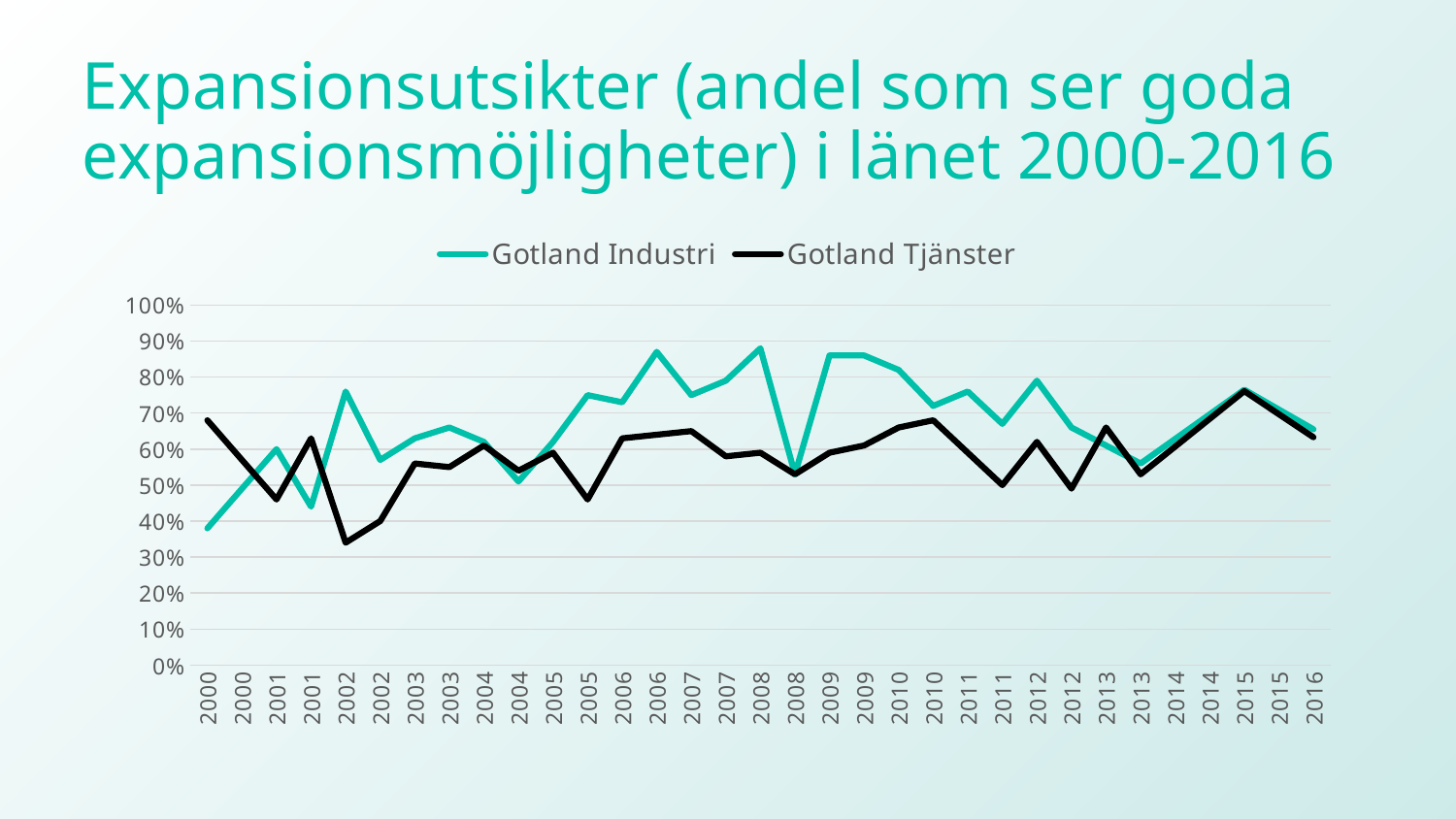
How many series does the legend list? 2 Is the first 2000 value for Gotland Tjänster greater or less than 60%? greater What are the two series named in the legend? Gotland Industri and Gotland Tjänster Does the Gotland Industri line rise or fall between the first and second 2008 points? fall What kind of chart is shown on the slide? line chart Is the first 2008 value for Gotland Industri greater or less than 80%? greater Which series is drawn with the black line? Gotland Tjänster Which series reaches the highest value anywhere on the chart? Gotland Industri Is the first 2000 value for Gotland Industri greater or less than 50%? less At the first 2002 point, which series has the higher value, Gotland Industri or Gotland Tjänster? Gotland Industri At the first 2000 point, which series has the higher value, Gotland Industri or Gotland Tjänster? Gotland Tjänster